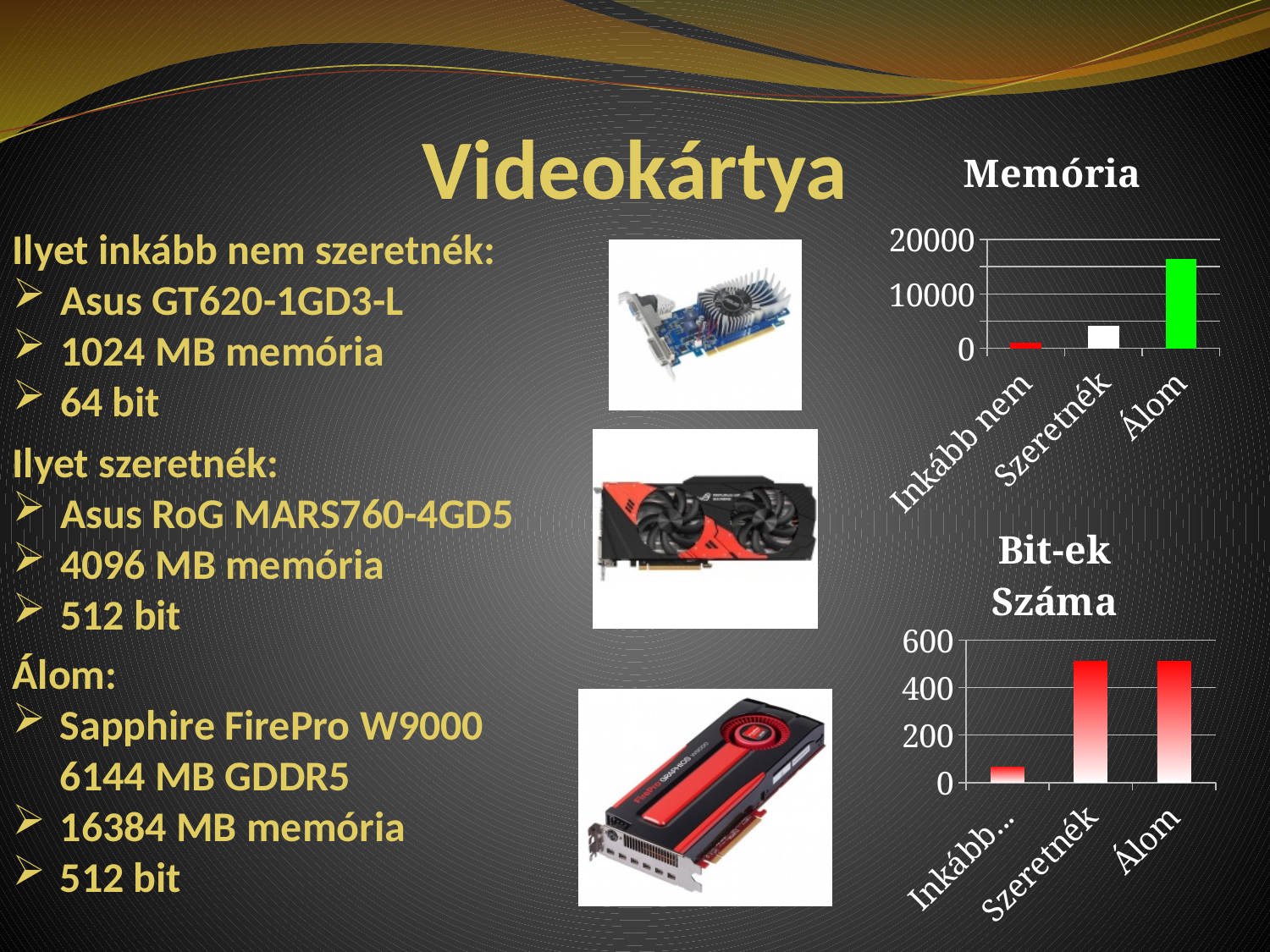
In the Bit-ek Száma chart, is the value for Szeretnék greater or less than 400? greater In the Memória chart, what colour is the bar for Álom? green What kind of chart is the Memória chart? bar chart In the Memória chart, which category has the lowest value? Inkább nem In the Memória chart, is the value for Álom greater or less than 10000? greater In the Bit-ek Száma chart, which is larger, the value for Álom or the value for Inkább...? Álom How many categories are shown in the Bit-ek Száma chart? 3 How many categories are shown in the Memória chart? 3 In the Bit-ek Száma chart, is the value for Inkább... greater or less than 200? less In the Memória chart, which category has the highest value? Álom In the Bit-ek Száma chart, which category has the lowest value? Inkább...